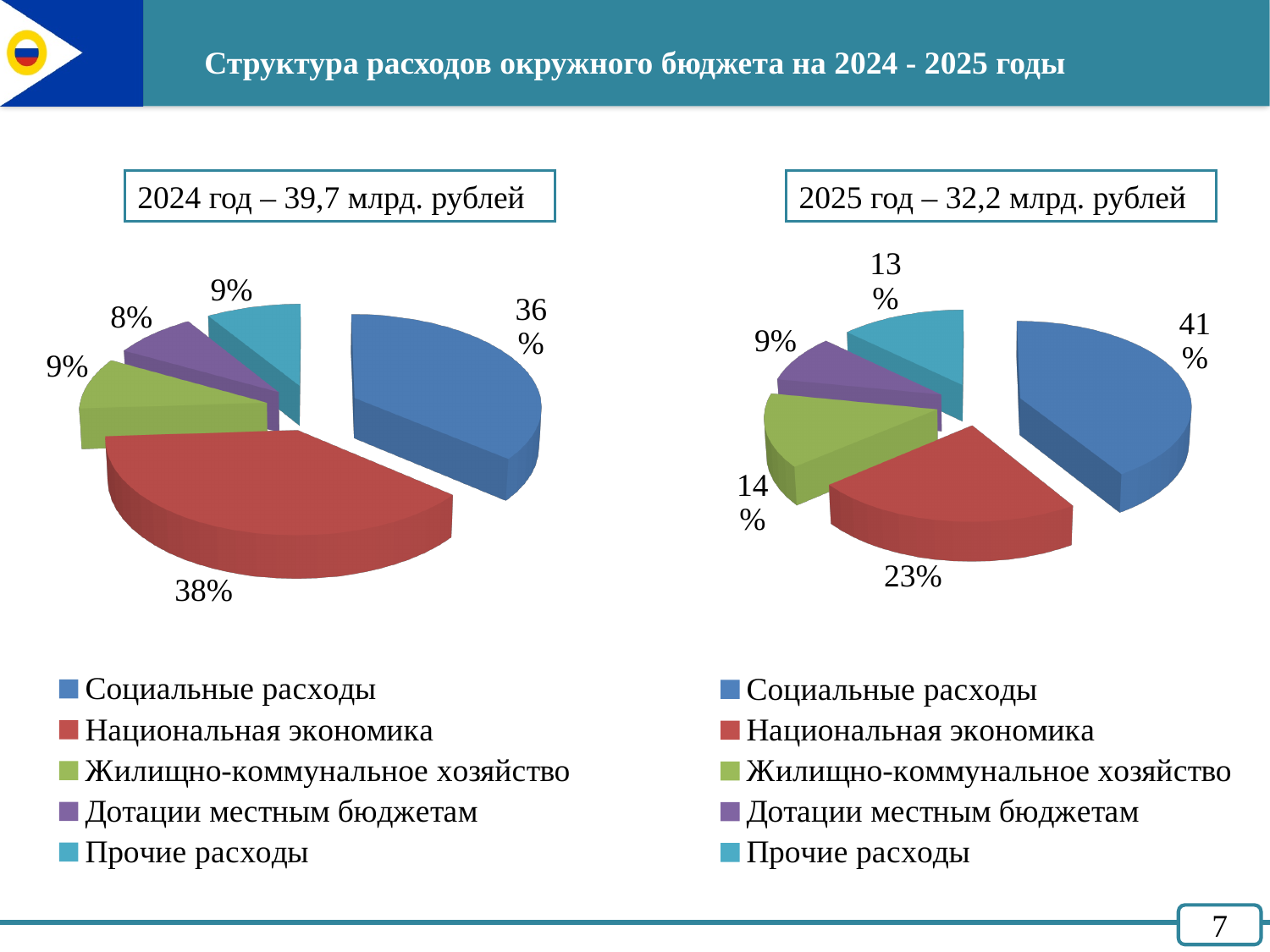
What type of chart is used for the 2025 data (right)? Pie chart In the 2025 pie chart (right), what share is Прочие расходы? 13% In the 2024 pie chart (left), which category has the largest share? Национальная экономика In the 2025 pie chart (right), which category has the largest share? Социальные расходы In the 2024 pie chart (left), which category has the smallest share? Дотации местным бюджетам In the 2025 pie chart (right), which is larger: Жилищно-коммунальное хозяйство or Дотации местным бюджетам? Жилищно-коммунальное хозяйство In the 2024 pie chart (left), what share is Национальная экономика? 38% In the 2025 pie chart (right), what share is Жилищно-коммунальное хозяйство? 14% In the 2025 pie chart (right), what is the difference between the shares of Социальные расходы and Национальная экономика? 18% How many categories does the legend of the 2024 pie chart (left) list? 5